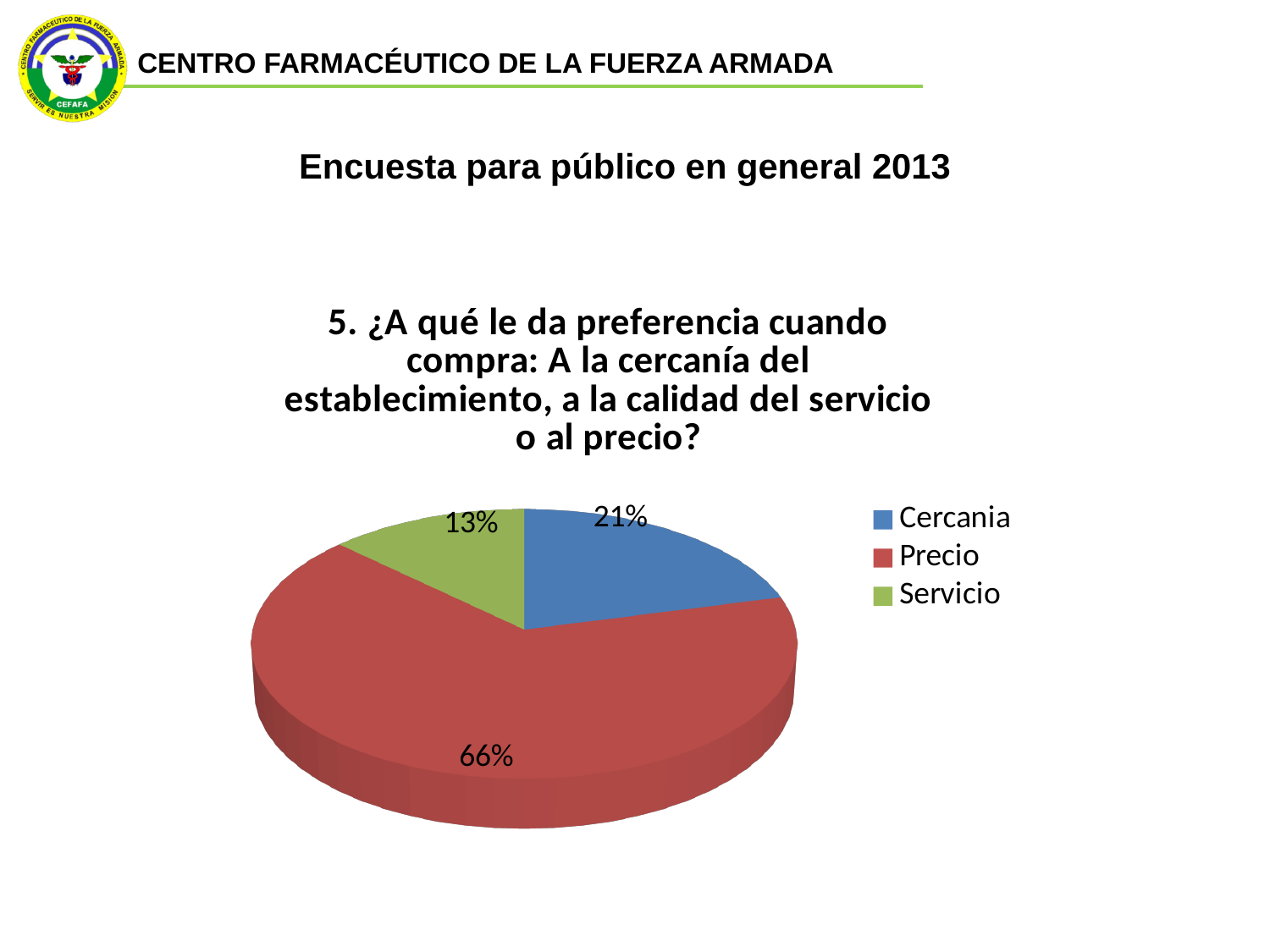
What share of the pie does Servicio have? 13% Which category has the smallest slice of the pie? Servicio What is the difference in percentage points between Precio and Cercania? 45 What share of the pie does Precio have? 66% How many categories does the pie chart show? 3 Which is larger, the share for Cercania or the share for Servicio? Cercania What colour is the Precio slice in the pie chart? Red What share of the pie does Cercania have? 21% Which category has the largest slice of the pie? Precio What is the difference in percentage points between Cercania and Servicio? 8 Which category is listed first in the legend? Cercania What kind of chart is shown on the slide? Pie chart